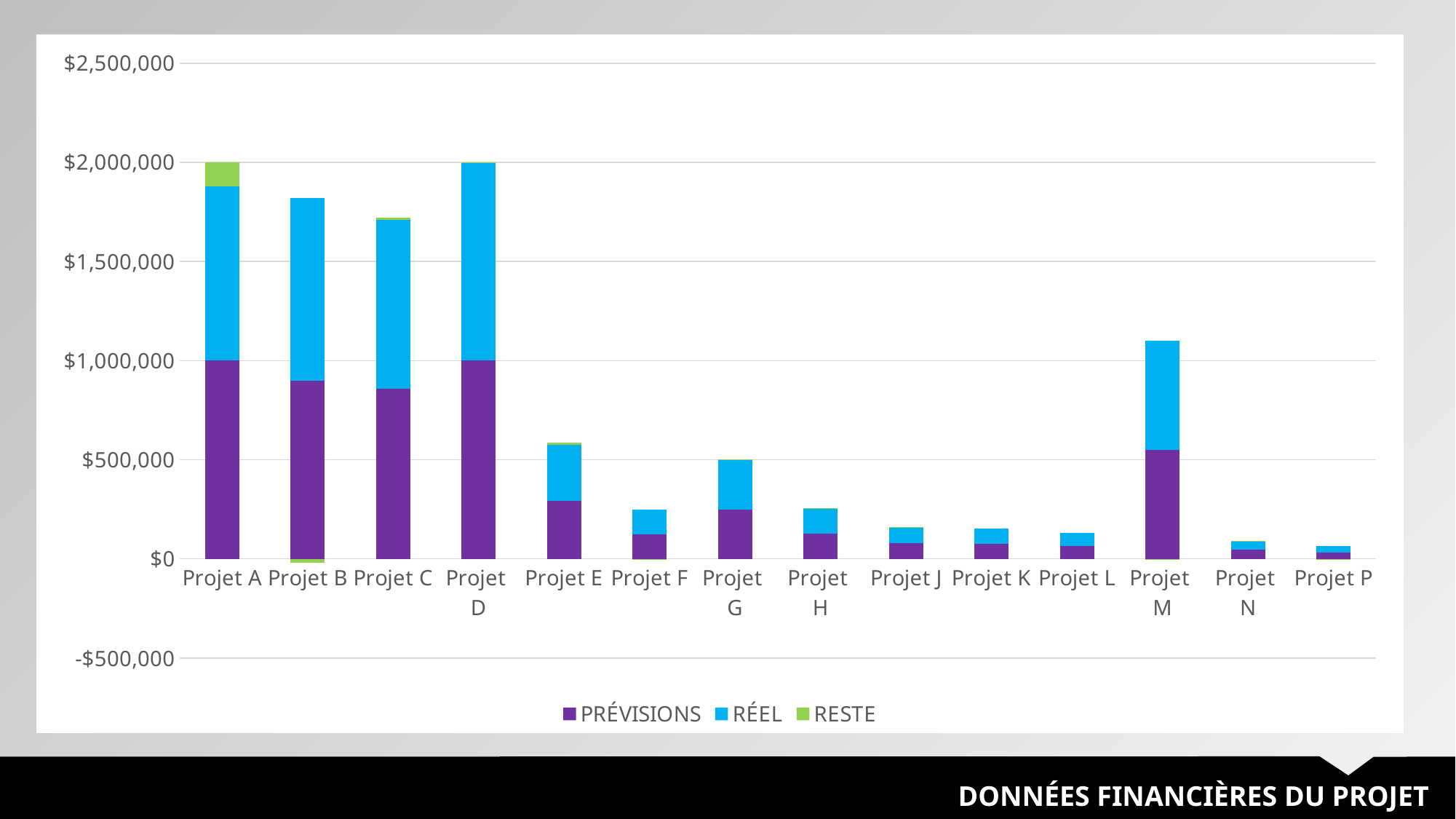
Which has the larger total stacked bar, Projet M or Projet G? Projet M Which project has the smallest total stacked bar? Projet P What is the PRÉVISIONS value for Projet A? $1,000,000 What are the three series named in the legend? PRÉVISIONS, RÉEL, RESTE Is the total stacked value for Projet B greater or less than $1,500,000? greater How many projects (categories) are plotted on the x axis? 14 What is the total height of the stacked bar for Projet D? $2,000,000 How many series does the legend list? 3 What is the title shown at the bottom of the slide? DONNÉES FINANCIÈRES DU PROJET What kind of chart is shown on the slide? Stacked bar chart Is the total stacked value for Projet F greater or less than $500,000? less Is the total stacked value for Projet M greater or less than $1,000,000? greater